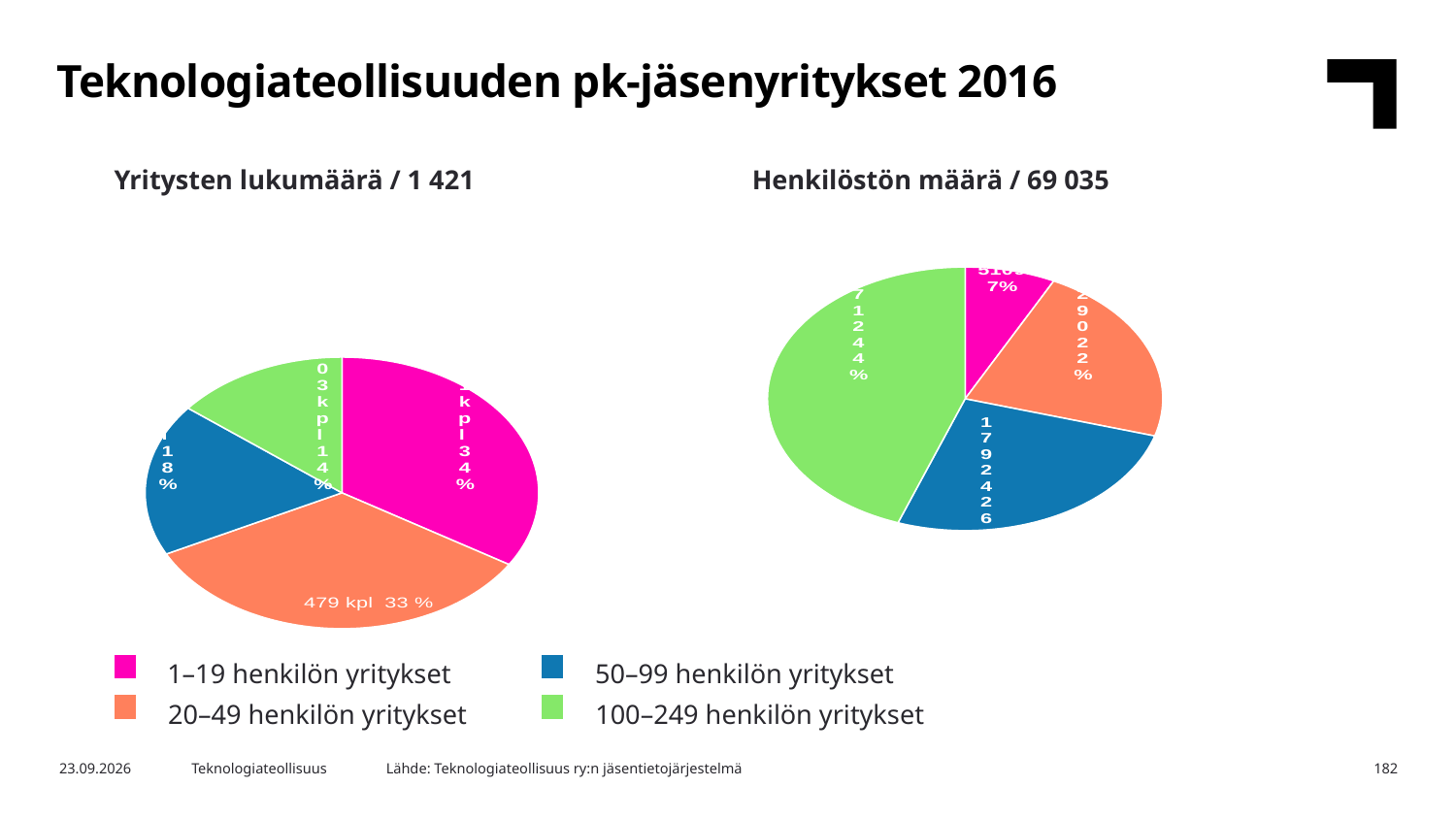
In the right pie chart (Henkilöstön määrä / 69 035), which has the larger share: 50–99 henkilön yritykset or 1–19 henkilön yritykset? 50–99 henkilön yritykset How many slices does the left pie chart (Yritysten lukumäärä / 1 421) have? 4 In the left pie chart (Yritysten lukumäärä / 1 421), what share do the 50–99 henkilön yritykset have? 18% In the right pie chart (Henkilöstön määrä / 69 035), what share do the 100–249 henkilön yritykset have? 44% In the right pie chart (Henkilöstön määrä / 69 035), which category has the smallest share? 1–19 henkilön yritykset In the left pie chart (Yritysten lukumäärä / 1 421), how many companies are in the 20–49 henkilön yritykset category? 479 kpl In the left pie chart (Yritysten lukumäärä / 1 421), what share do the 20–49 henkilön yritykset have? 33 % In the left pie chart (Yritysten lukumäärä / 1 421), which category has the smallest share? 100–249 henkilön yritykset In the left pie chart (Yritysten lukumäärä / 1 421), which category has the largest share? 1–19 henkilön yritykset How many categories does the legend list? 4 What kind of chart is used on this slide? Pie chart In the right pie chart (Henkilöstön määrä / 69 035), which category has the largest share? 100–249 henkilön yritykset